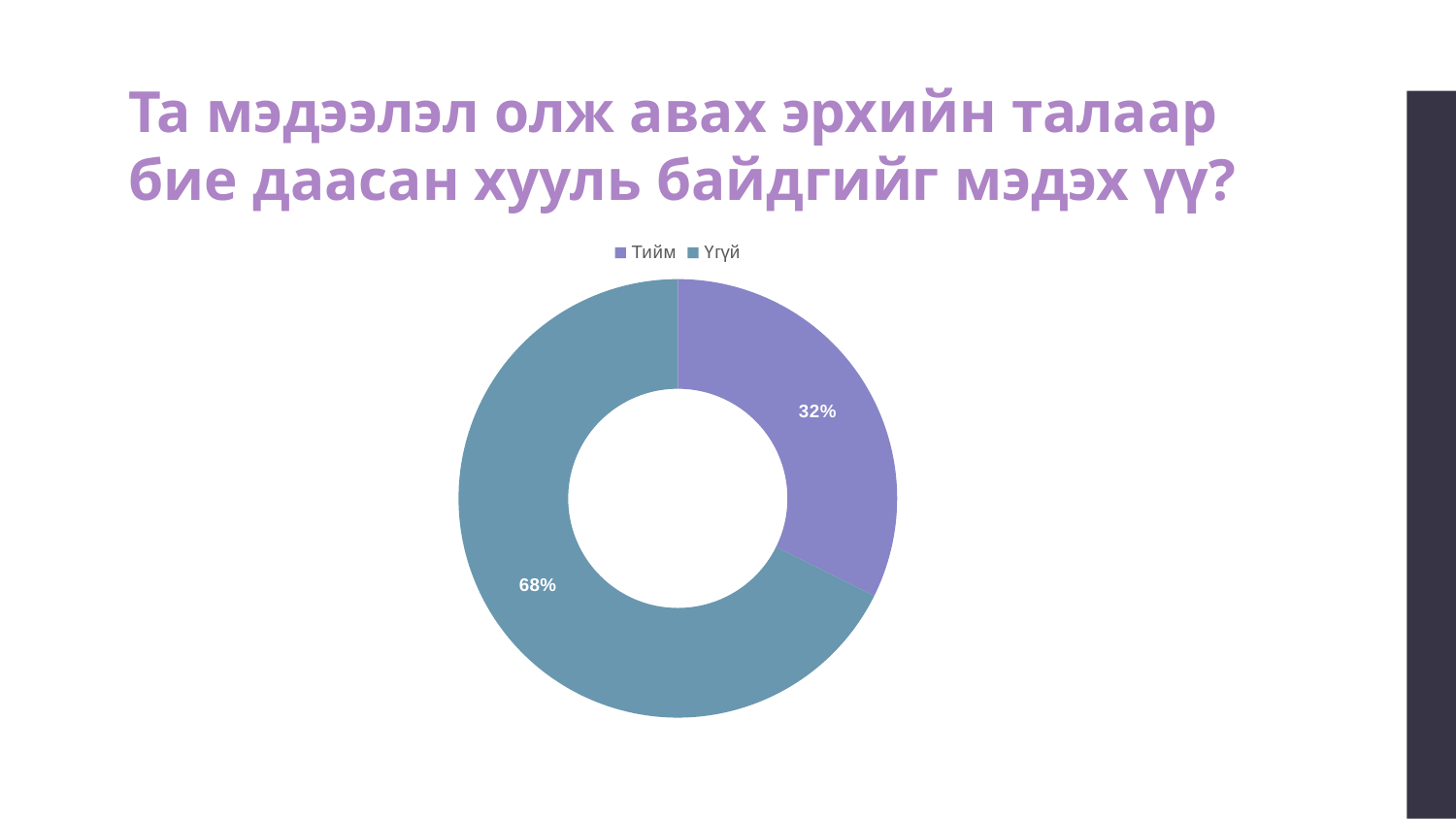
Which is larger, the Тийм slice or the Үгүй slice? Үгүй What is the title of the slide above the chart? Та мэдээлэл олж авах эрхийн талаар бие даасан хууль байдгийг мэдэх үү? Is the value for Үгүй greater or less than 50%? greater How many categories are shown in the chart? 2 What share of the chart does the Үгүй slice represent? 68% What share of the chart does the Тийм slice represent? 32% Which category has the smallest slice? Тийм Which category has the largest slice? Үгүй What colour is the Тийм slice? Purple How many entries does the legend list? 2 What kind of chart is shown on the slide? Doughnut (pie) chart What is the difference in percentage points between the Үгүй and Тийм slices? 36